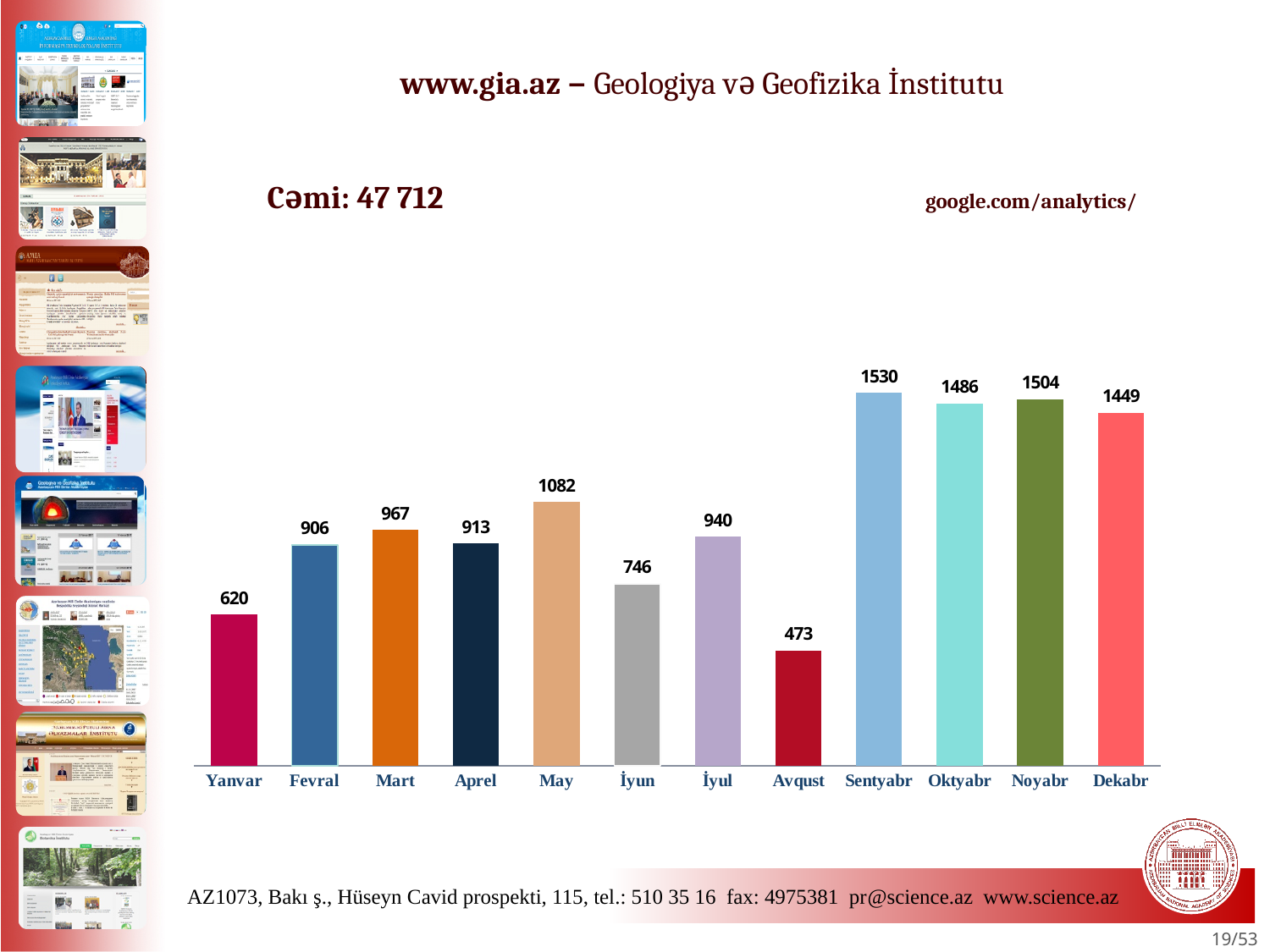
What kind of chart is shown on the slide? bar chart What is the difference between the values for Sentyabr and Avqust? 1057 How many months are shown on the chart? 12 What is the value for May? 1082 What is the difference between the values for Fevral and Yanvar? 286 What total (Cəmi) is stated on the slide? 47 712 Which month has the highest value? Sentyabr What is the value for Sentyabr? 1530 Which is larger, the value for Mart or the value for Aprel? Mart Which is larger, the value for İyul or the value for İyun? İyul Which month has the lowest value? Avqust What is the value for Avqust? 473